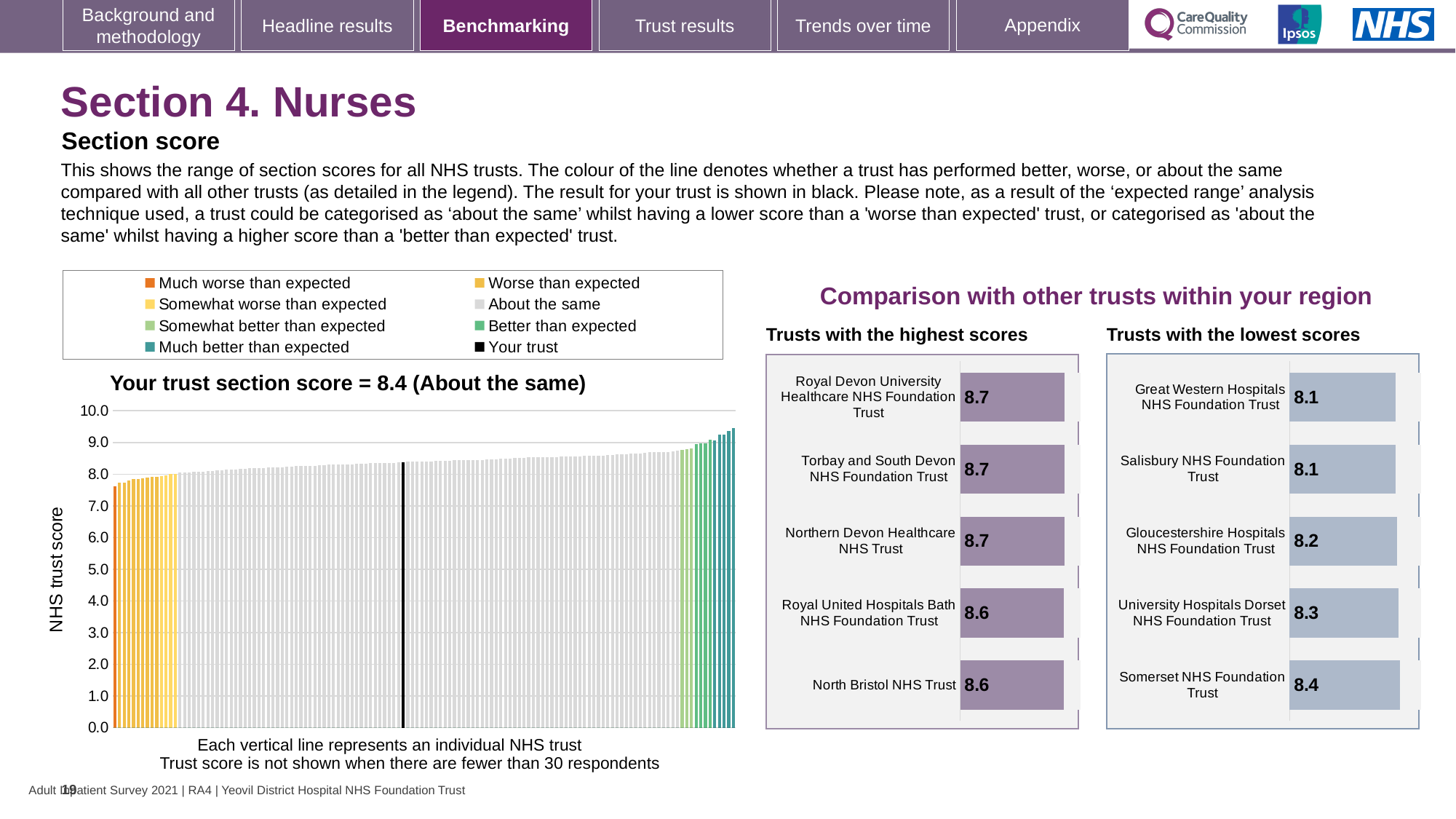
In the 'Trusts with the lowest scores' chart, what is the score for Gloucestershire Hospitals NHS Foundation Trust? 8.2 In the main 'Your trust section score' chart, what is the section score for your trust? 8.4 In the 'Trusts with the highest scores' chart, what is the score for North Bristol NHS Trust? 8.6 In the 'Trusts with the lowest scores' chart, which trust has the highest score? Somerset NHS Foundation Trust In the 'Trusts with the lowest scores' chart, what is the difference between the scores of Somerset NHS Foundation Trust and Great Western Hospitals NHS Foundation Trust? 0.3 In the main 'Your trust section score' chart, is the value of the highest-scoring trust greater or less than 9.0? greater How many entries does the legend above the main 'Your trust section score' chart list? 8 In the 'Trusts with the lowest scores' chart, which has the larger score: Gloucestershire Hospitals NHS Foundation Trust or University Hospitals Dorset NHS Foundation Trust? University Hospitals Dorset NHS Foundation Trust What kind of chart is the main 'Your trust section score' chart? Bar chart In the 'Trusts with the highest scores' chart, what is the score for Royal Devon University Healthcare NHS Foundation Trust? 8.7 In the main 'Your trust section score' chart, is the value of the lowest-scoring trust greater or less than 7.0? greater How many trusts are listed in the 'Trusts with the highest scores' chart? 5